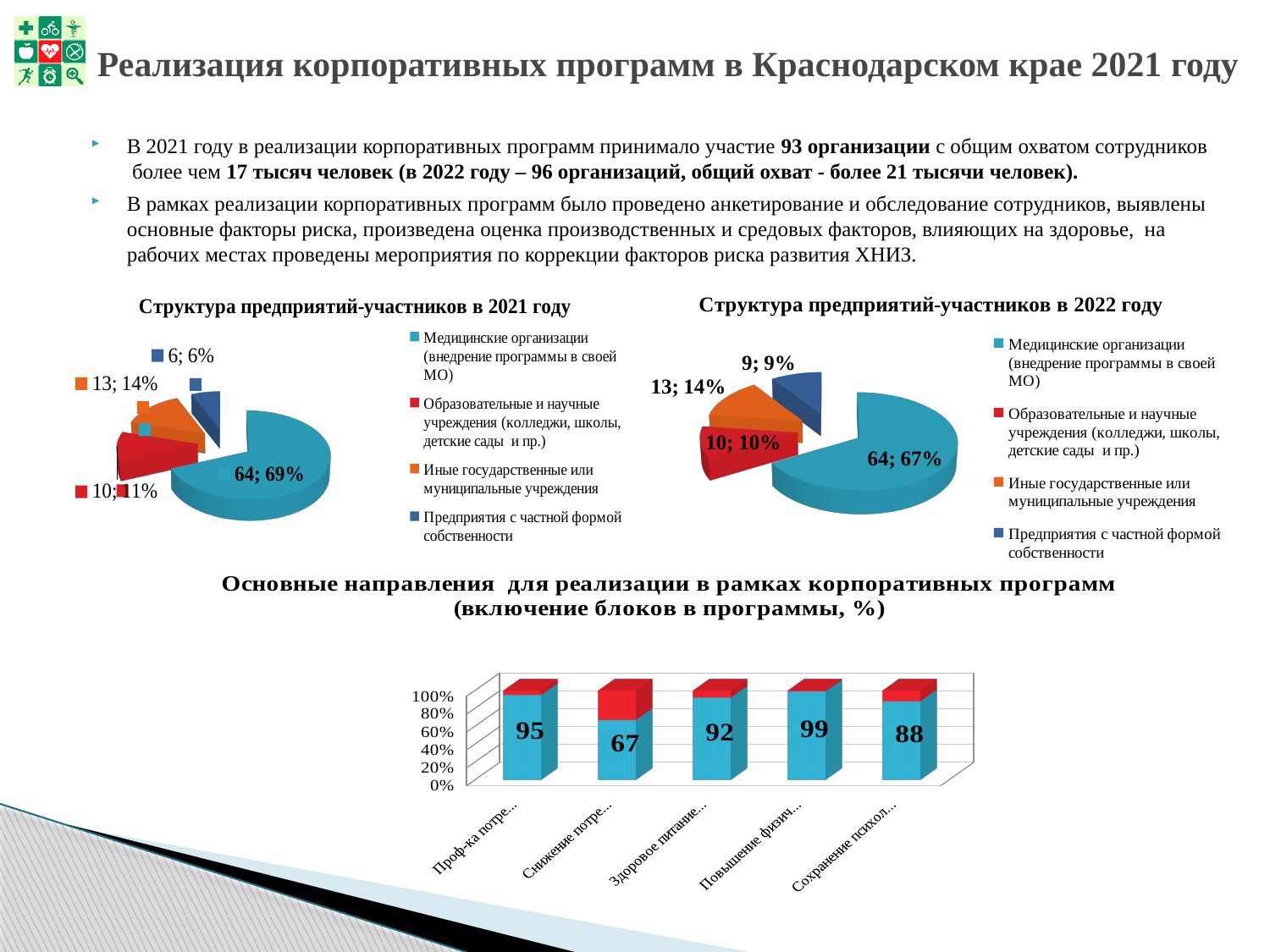
In the bar chart 'Основные направления для реализации в рамках корпоративных программ', which category has the highest value? Повышение физич... (99) How many categories are shown on the x axis of the bar chart 'Основные направления для реализации в рамках корпоративных программ'? 5 In the pie chart 'Структура предприятий-участников в 2021 году', what share do Медицинские организации have? 69% In the pie chart 'Структура предприятий-участников в 2022 году', what is the value and share for Предприятия с частной формой собственности? 9; 9% What type of chart is used for 'Структура предприятий-участников в 2021 году'? Pie chart How many categories does the legend of the pie chart 'Структура предприятий-участников в 2022 году' list? 4 In the pie chart 'Структура предприятий-участников в 2021 году', how many more organisations are Иные государственные или муниципальные учреждения than Предприятия с частной формой собственности? 7 In the bar chart 'Основные направления для реализации в рамках корпоративных программ', what is the difference between the first bar (95) and the last bar (88)? 7 In the pie chart 'Структура предприятий-участников в 2022 году', which category has the largest share? Медицинские организации (внедрение программы в своей МО) In the pie chart 'Структура предприятий-участников в 2021 году', which category has the smallest share? Предприятия с частной формой собственности Comparing the two pie charts, is the share of Медицинские организации larger in 2021 or in 2022? 2021 In the bar chart 'Основные направления для реализации в рамках корпоративных программ', what is the value of the second bar (Снижение потре...)? 67